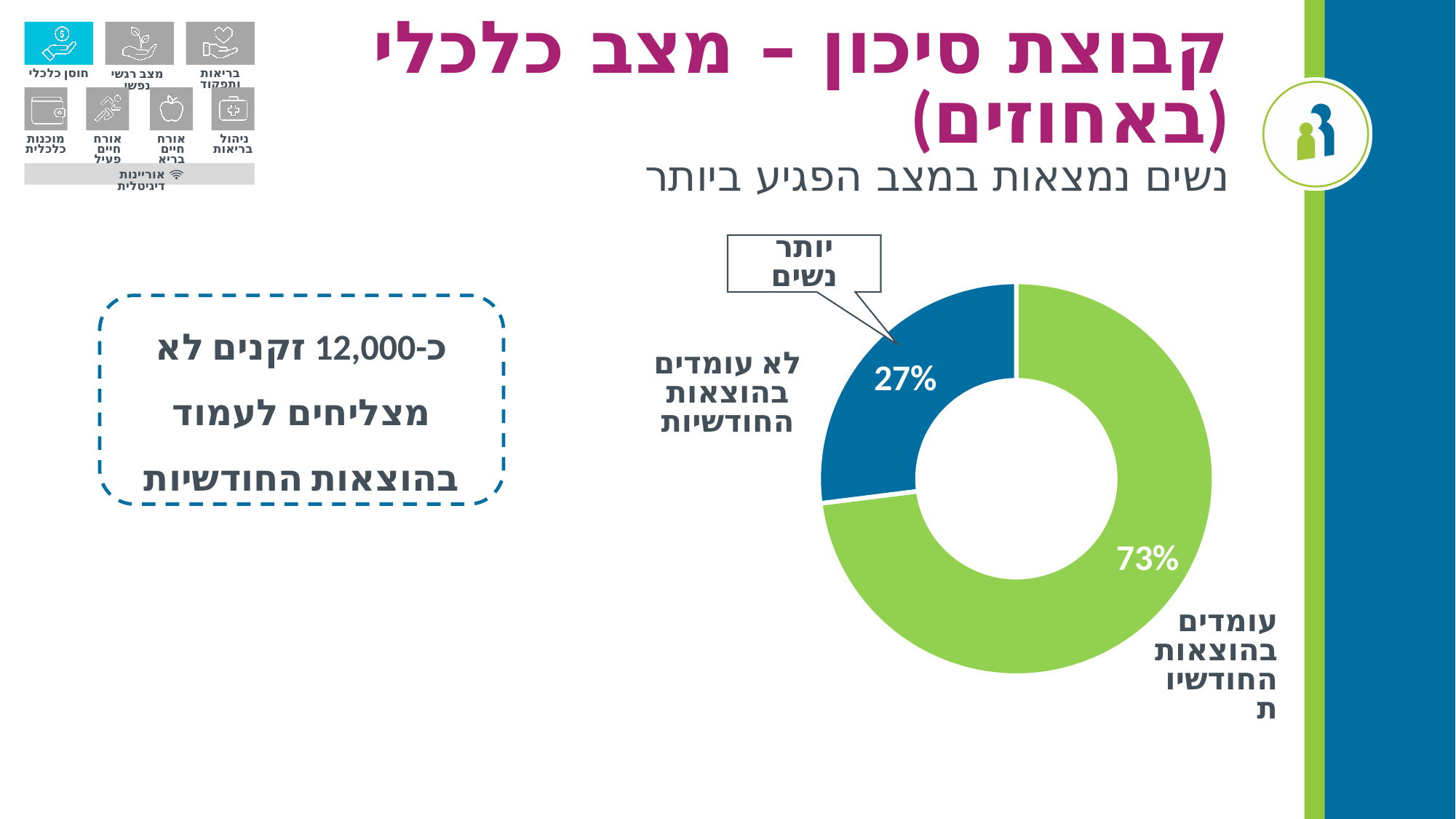
What share of the pie does the blue slice represent? 27% What percentage of the pie is labelled "לא עומדים בהוצאות החודשיות"? 27% Which slice of the pie is the smallest? לא עומדים בהוצאות החודשיות What percentage of the pie is labelled "עומדים בהוצאות החודשיות"? 73% How many slices does the pie chart have? 2 What is the difference in percentage points between the "עומדים בהוצאות החודשיות" slice and the "לא עומדים בהוצאות החודשיות" slice? 46 percentage points What kind of chart is shown on the slide? Pie chart (donut) Which is larger: the "עומדים בהוצאות החודשיות" slice or the "לא עומדים בהוצאות החודשיות" slice? עומדים בהוצאות החודשיות What does the callout box pointing to the 27% slice say? יותר נשים Which slice of the pie is the largest? עומדים בהוצאות החודשיות What colour is the "עומדים בהוצאות החודשיות" slice? Green